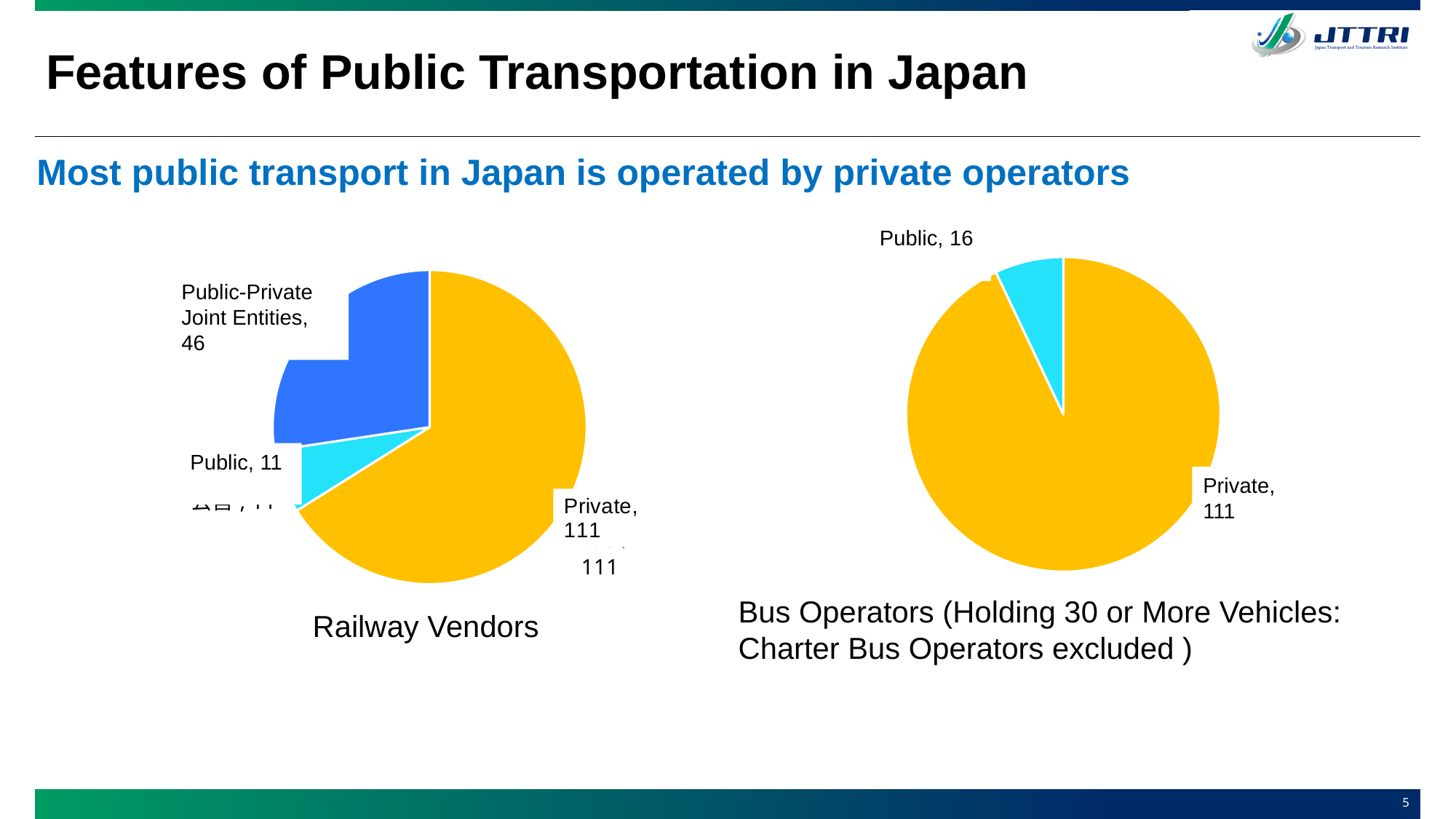
In the Railway Vendors chart, what is the difference between Private and Public-Private Joint Entities? 65 In the Railway Vendors chart, what is the value for Public? 11 In the Railway Vendors chart, which category has the smallest slice? Public What type of chart is used for Railway Vendors? Pie chart In the Bus Operators chart, what is the difference between Private and Public? 95 How many labelled categories does the Railway Vendors chart show? 3 In the Bus Operators chart, what is the value for Public? 16 In the Bus Operators chart, which is larger, Private or Public? Private In the Bus Operators chart, what is the value for Private? 111 In the Railway Vendors chart, what is the value for Private? 111 In the Railway Vendors chart, what is the value for Public-Private Joint Entities? 46 In the Railway Vendors chart, which category has the largest slice? Private